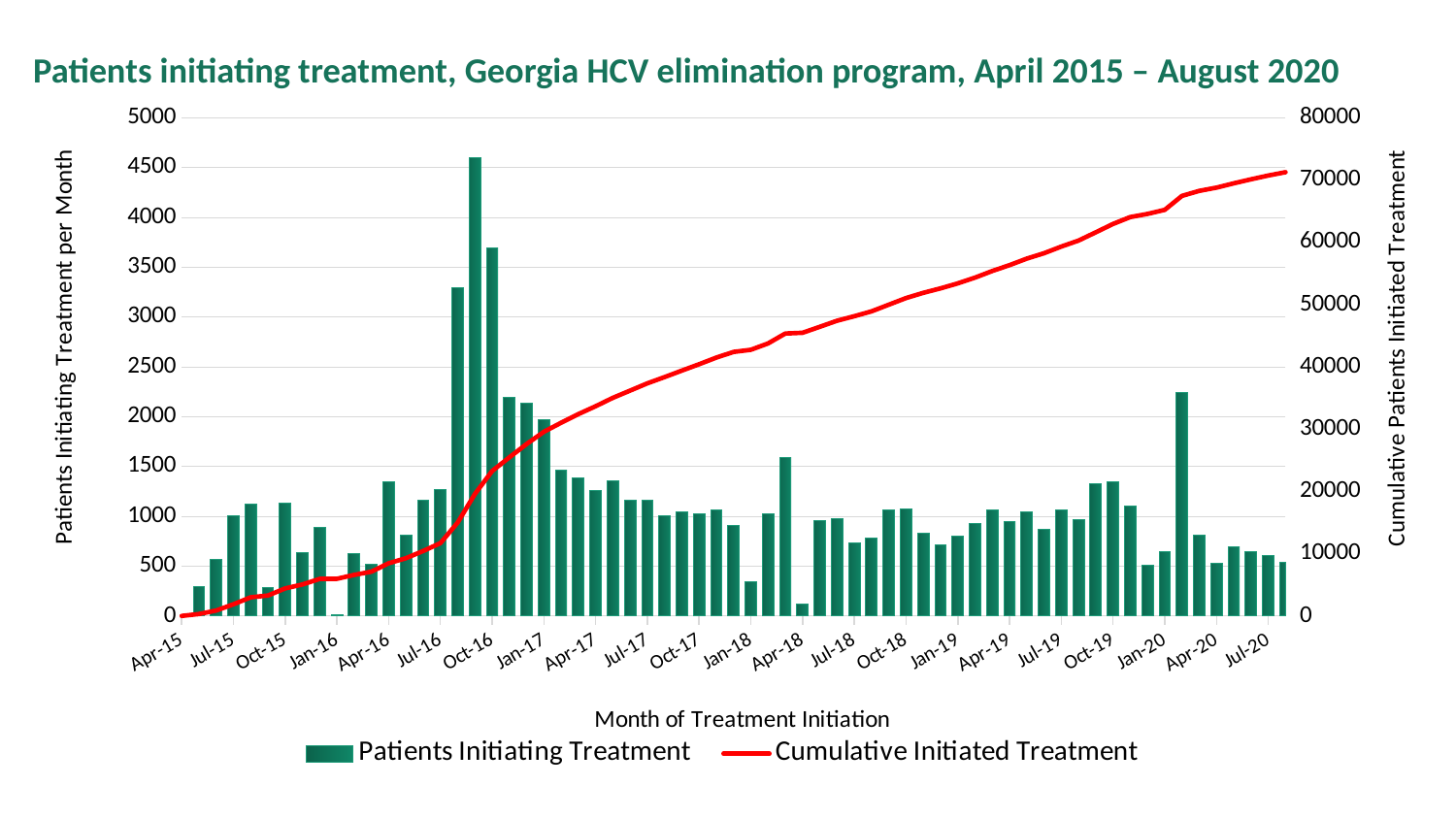
Which series is drawn as a red line? Cumulative Initiated Treatment Is the Cumulative Initiated Treatment value at Jul-20 greater or less than 80000? less Is the number of Patients Initiating Treatment in Oct-16 greater or less than 4000? less Is the number of Patients Initiating Treatment in Apr-15 greater or less than 500? less What is the title of the chart? Patients initiating treatment, Georgia HCV elimination program, April 2015 – August 2020 Does the Cumulative Initiated Treatment line rise or fall from Apr-15 to Jul-20? Rises How many series does the legend list? 2 What kind of chart is shown on the slide? A combined bar and line chart Which month has more Patients Initiating Treatment, Oct-16 or Apr-20? Oct-16 In which month is the bar for Patients Initiating Treatment highest? Sep-16